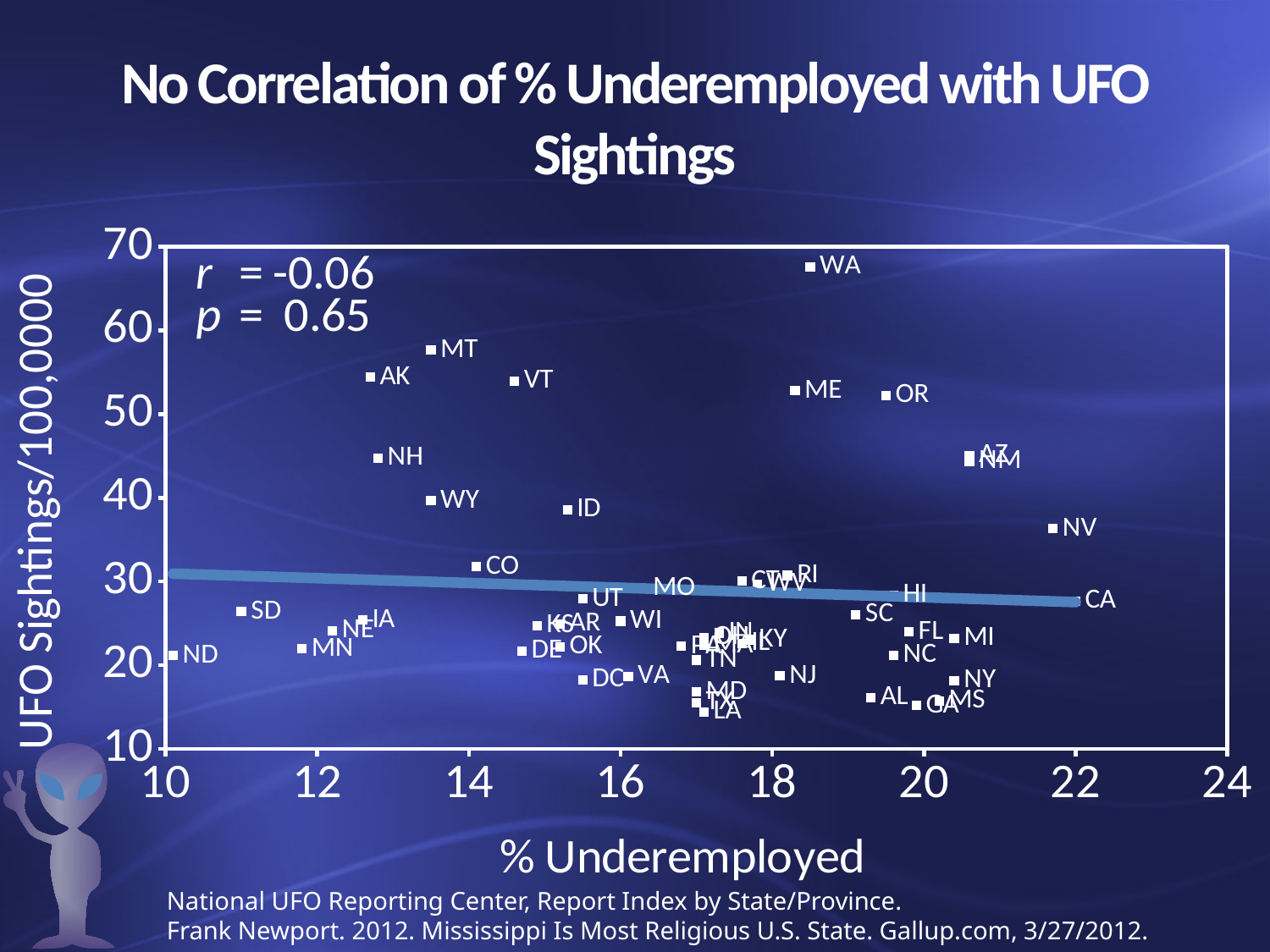
What correlation coefficient r is printed on the chart? -0.06 Which state has the lowest % Underemployed on the chart? ND Which state has the highest UFO sightings per 100,000 on the chart? WA Is the UFO sightings value for ND greater or less than 30? less What kind of chart is shown on the slide? scatter plot Which state has more UFO sightings per 100,000, AK or NH? AK Which state has more UFO sightings per 100,000, MT or VT? MT Which state has the highest % Underemployed on the chart? CA Is the UFO sightings value for WA greater or less than 60? greater Is the UFO sightings value for NV greater or less than 30? greater Does the fitted trend line rise or fall as % Underemployed increases? falls slightly